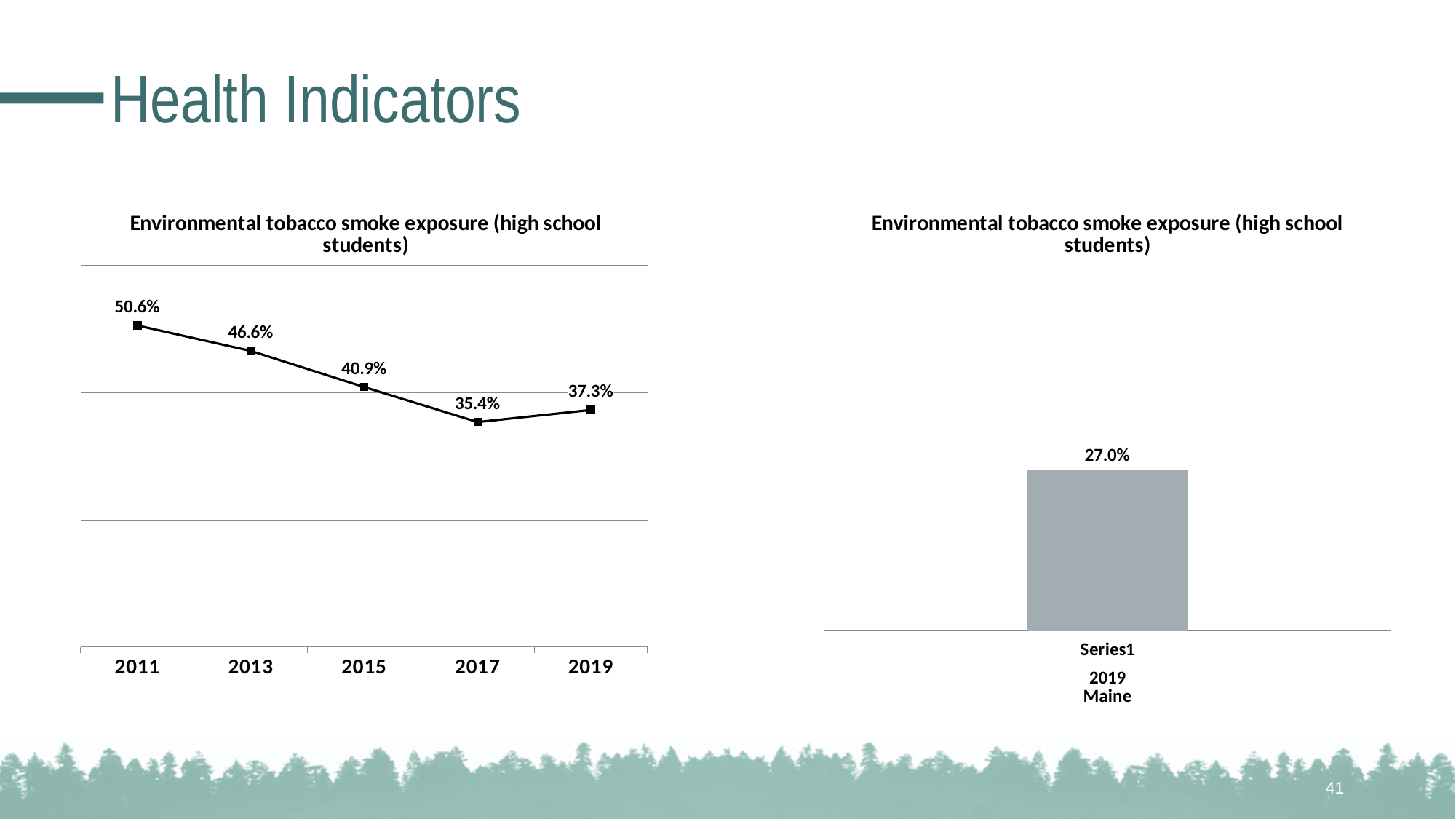
In the left chart, which is larger, the value for 2013 or the value for 2015? 2013 In the left chart, what is the value for 2019? 37.3% In the left chart, which year has the highest value? 2011 In the left chart, what is the value for 2017? 35.4% In the left chart, what is the value for 2011? 50.6% How many data points are plotted in the left chart? 5 In the left chart, do the values generally rise or fall from 2011 to 2017? fall In the left chart, which year has the lowest value? 2017 In the left chart, what is the difference between the 2011 and 2019 values? 13.3% What kind of chart is the right chart? bar chart In the right chart, what is the value of the bar for 2019 Maine? 27.0% What kind of chart is the left chart? line chart